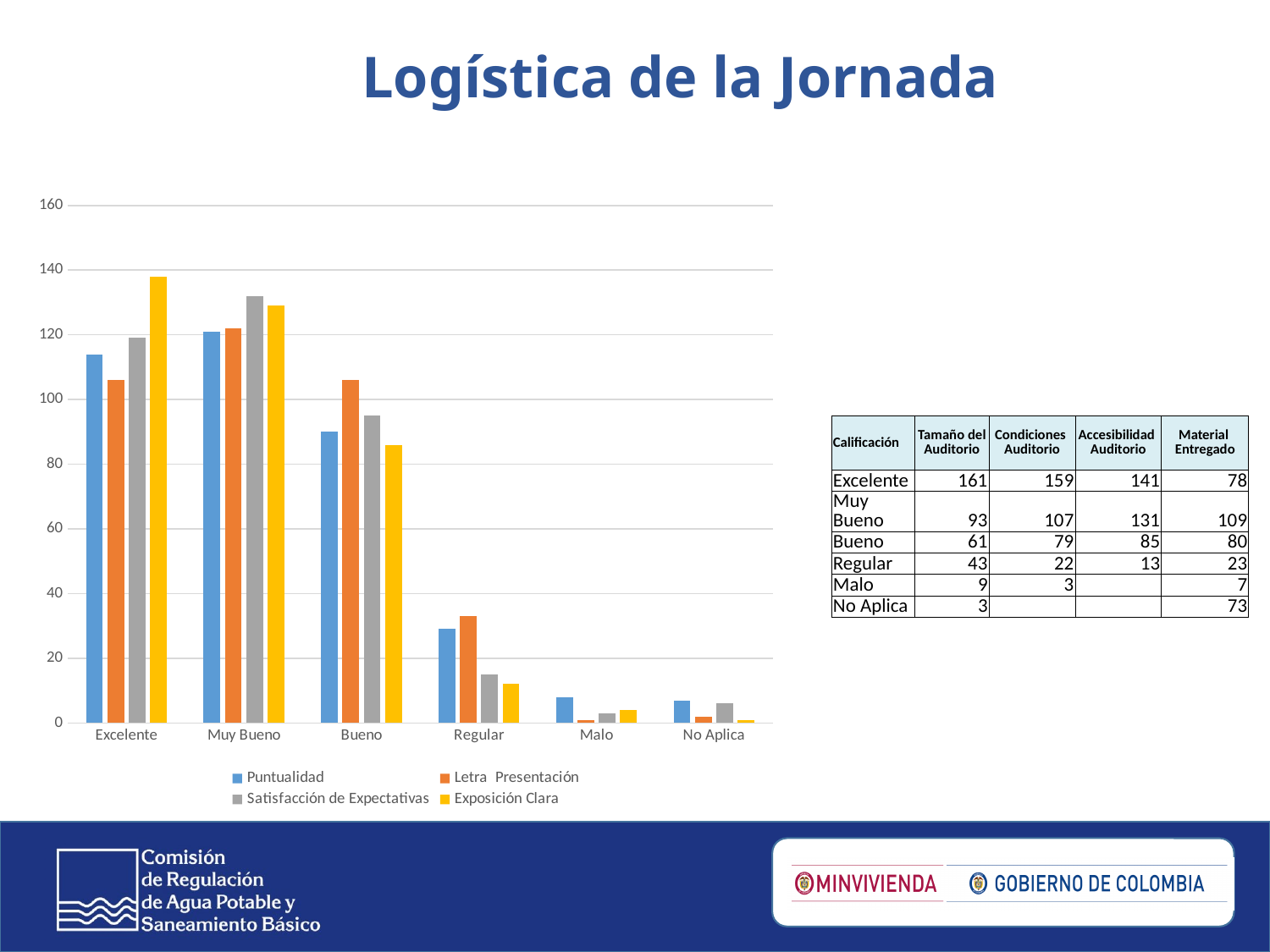
For the Satisfacción de Expectativas series, which category has the highest bar? Muy Bueno For Puntualidad, which is larger: Excelente or Muy Bueno? Muy Bueno Is the value for Satisfacción de Expectativas at Regular greater or less than 20? less Is the value for Puntualidad at Bueno greater or less than 100? less Do the Puntualidad values rise or fall from Muy Bueno to Malo along the x axis? fall At Bueno, which is larger: Puntualidad or Letra Presentación? Letra Presentación What colour represents the Exposición Clara series in the chart? yellow How many categories are shown on the x axis of the chart? 6 For the Exposición Clara series, which category has the highest bar? Excelente How many series does the chart legend list? 4 What kind of chart is shown on the slide? bar chart Is the value for Exposición Clara at Excelente greater or less than 120? greater